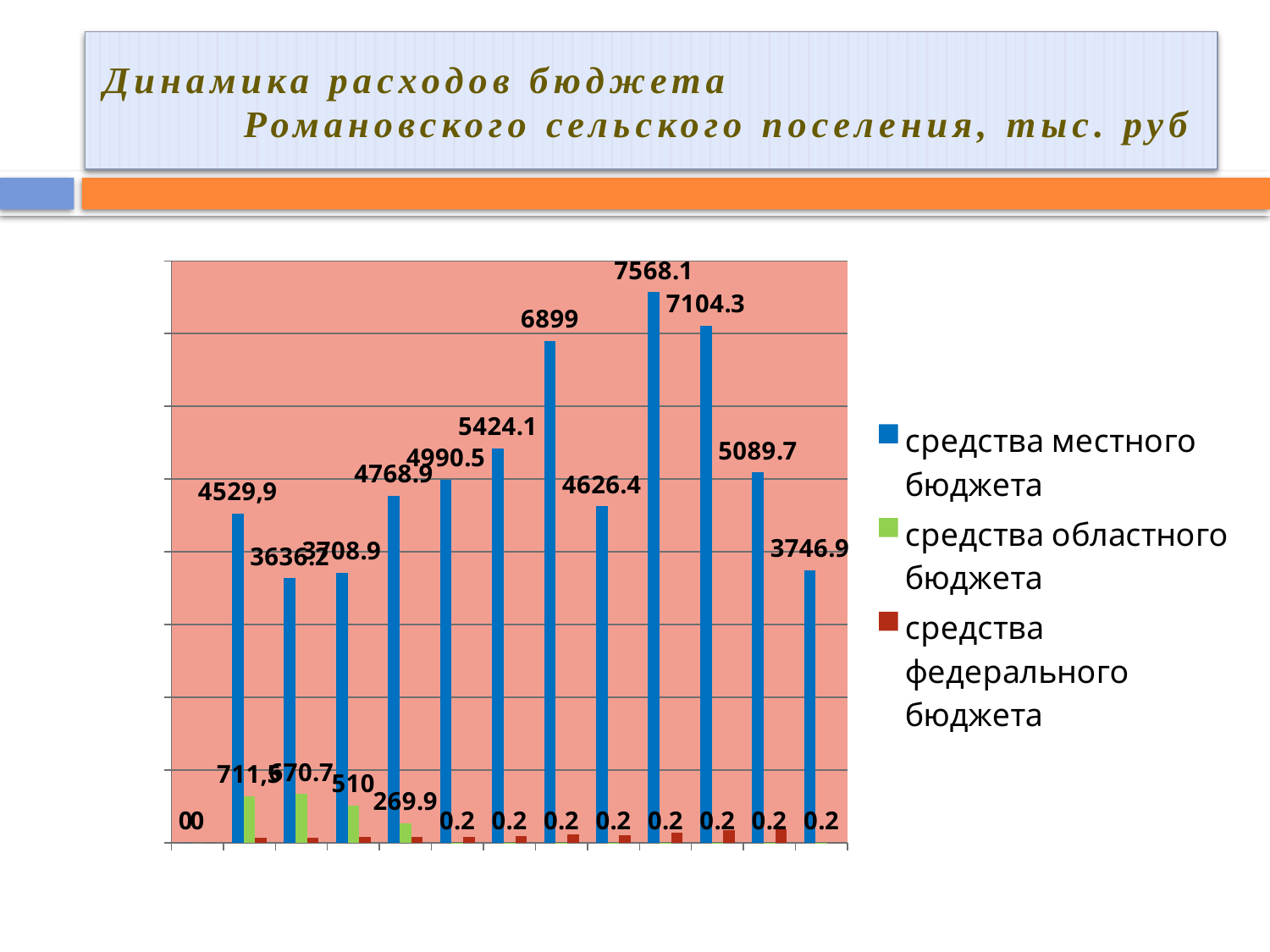
What is the difference between the two tallest 'средства местного бюджета' bars, labelled 7568.1 and 7104.3? 463.8 Which series is shown in blue according to the legend? средства местного бюджета What is the lowest value shown for the series 'средства местного бюджета'? 3636.2 What kind of chart is shown on the slide? bar chart How many 'средства областного бюджета' bars are labelled 0.2? 8 How many series does the legend list? 3 Which series is shown in dark red according to the legend? средства федерального бюджета How many groups of bars (categories) are plotted along the x axis? 12 What is the highest labelled value for the series 'средства областного бюджета'? 711,6 Which is larger: the first 'средства местного бюджета' bar (4529,9) or the last one (3746.9)? 4529,9 What is the highest value shown for the series 'средства местного бюджета'? 7568.1 What is the difference between the highest and lowest labelled values of 'средства местного бюджета'? 3931.9